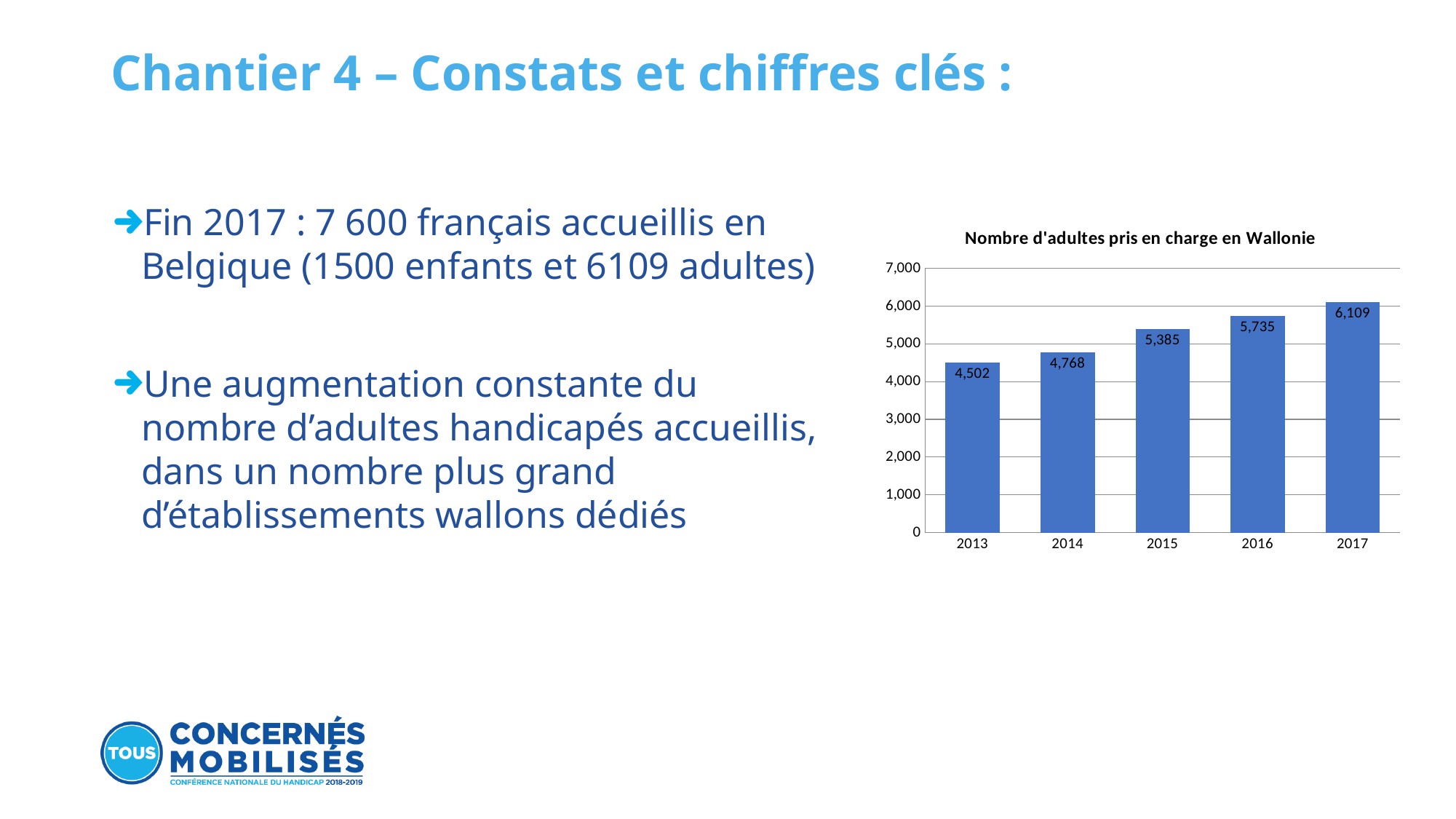
What is the value for 2015? 5,385 What is the value for 2017? 6,109 What is the value for 2013? 4,502 How many years are shown on the x axis? 5 Which year has the lowest value? 2013 Which is larger, the value for 2014 or the value for 2016? 2016 Is the value for 2017 greater or less than 6,000? greater What is the difference between the values for 2017 and 2013? 1,607 What kind of chart is shown? bar chart Which year has the highest value? 2017 Do the values rise or fall from 2013 to 2017? rise What is the difference between the values for 2016 and 2015? 350